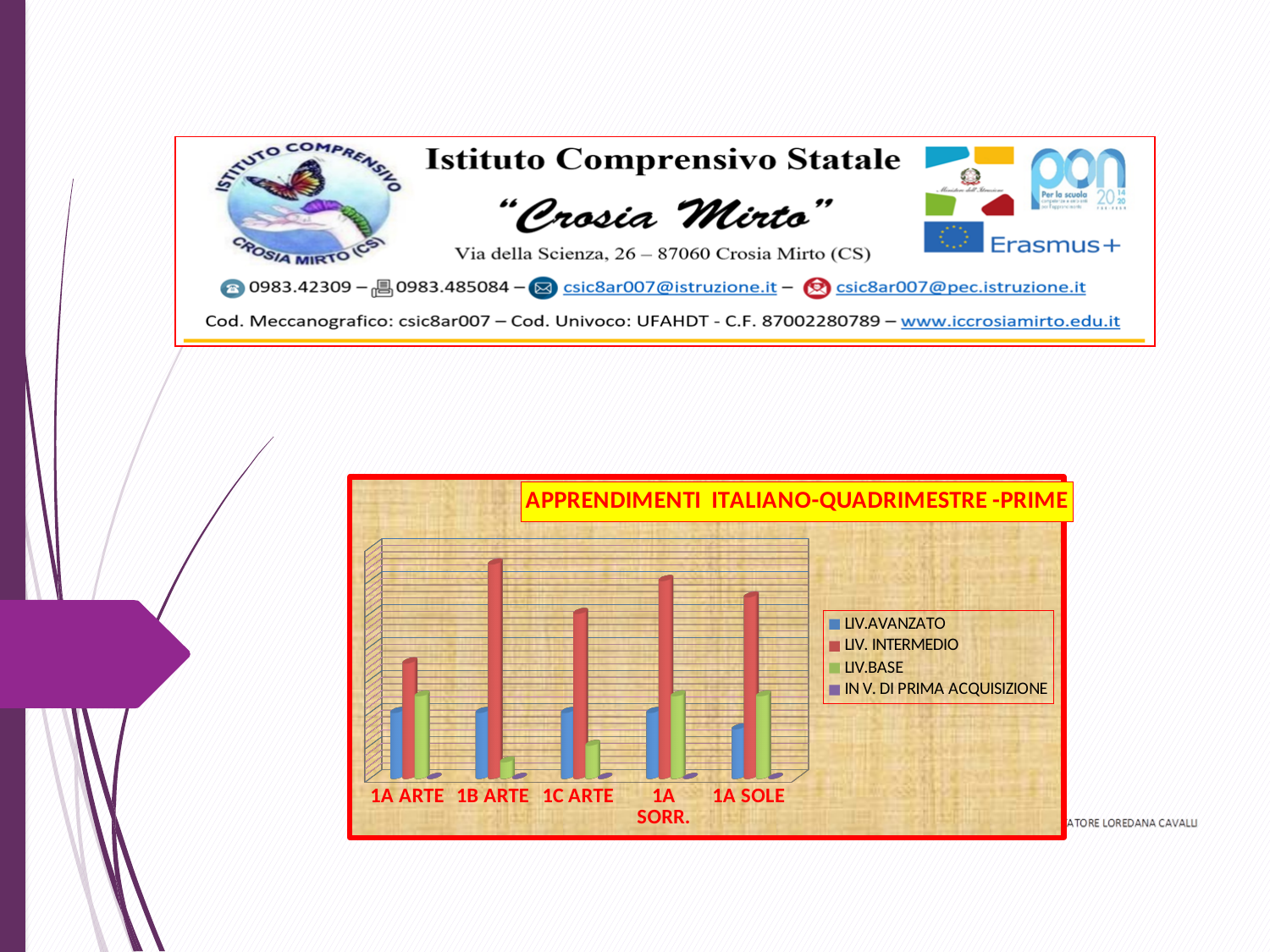
Which class has the shortest LIV. INTERMEDIO bar? 1A ARTE In the 1A SORR. class, which series has the tallest bar? LIV. INTERMEDIO What kind of chart is shown on the slide? bar chart Is the LIV. INTERMEDIO bar larger for 1B ARTE or for 1A ARTE? 1B ARTE Which class has the shortest LIV.BASE bar? 1B ARTE Which series is shown in red in the chart legend? LIV. INTERMEDIO How many series does the chart legend list? 4 Is the LIV.BASE bar larger for 1A ARTE or for 1B ARTE? 1A ARTE How many classes (categories) are shown on the x axis of the chart? 5 Which class has the tallest LIV. INTERMEDIO bar? 1B ARTE Which class has the shortest LIV.AVANZATO bar? 1A SOLE What is the title of the chart? APPRENDIMENTI ITALIANO-QUADRIMESTRE -PRIME